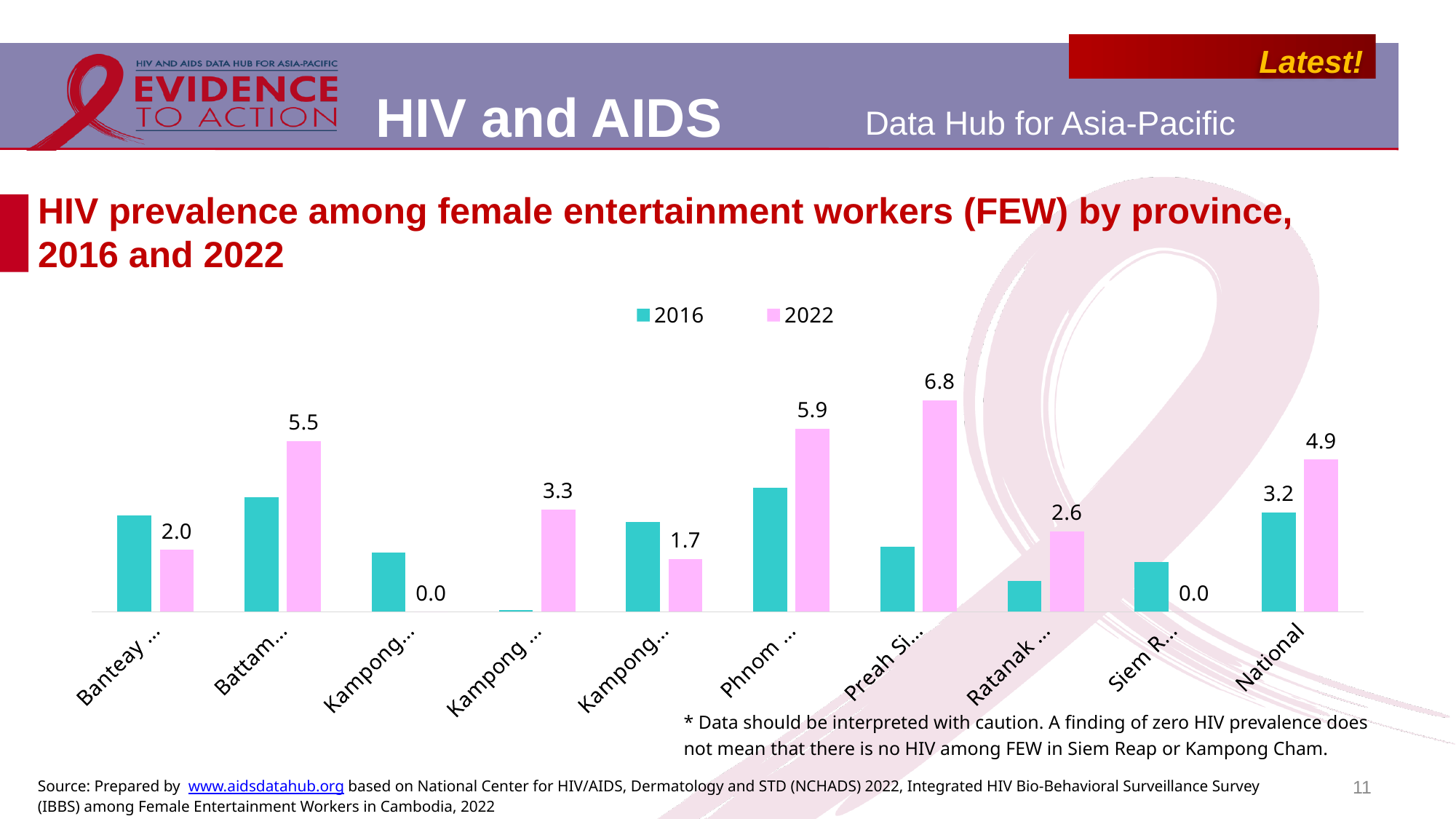
What is the 2022 value for National? 4.9 What kind of chart is shown on the slide? Bar chart What is the highest 2022 value shown on the chart? 6.8 For National, which is larger: the 2016 value or the 2022 value? 2022 What is the 2022 value for the first category from the left (Banteay ...)? 2.0 What is the 2022 value for the seventh category from the left (Preah Si...)? 6.8 What is the difference between the 2022 value for Battam... (second from the left) and the 2022 value for National? 0.6 What is the 2022 value for the second category from the left (Battam...)? 5.5 How many categories are shown on the x axis? 10 What is the lowest 2022 value shown on the chart? 0.0 Which category has the highest 2022 value? Preah Si... (seventh from the left) How many series does the legend list? 2